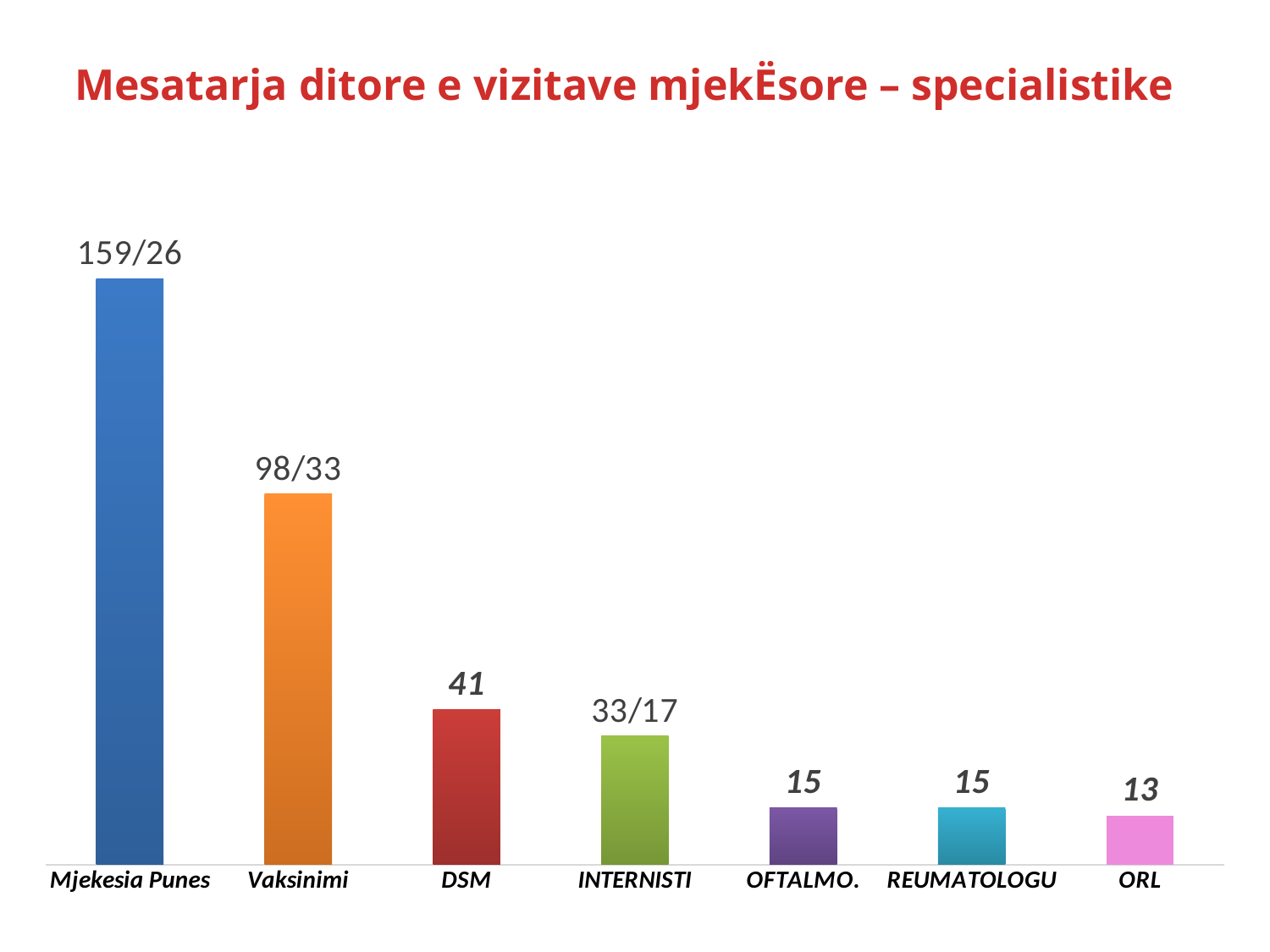
What is the value for ORL? 13 What is the value for DSM? 41 What is the data label shown for Mjekesia Punes? 159/26 Which category has the shortest bar? ORL What is the value for REUMATOLOGU? 15 What is the data label shown for INTERNISTI? 33/17 What is the data label shown for Vaksinimi? 98/33 What is the difference between the values for DSM and ORL? 28 What kind of chart is shown on the slide? Bar chart Which is larger, the value for DSM or the value for OFTALMO.? DSM How many categories are shown on the chart? 7 Which category has the tallest bar? Mjekesia Punes